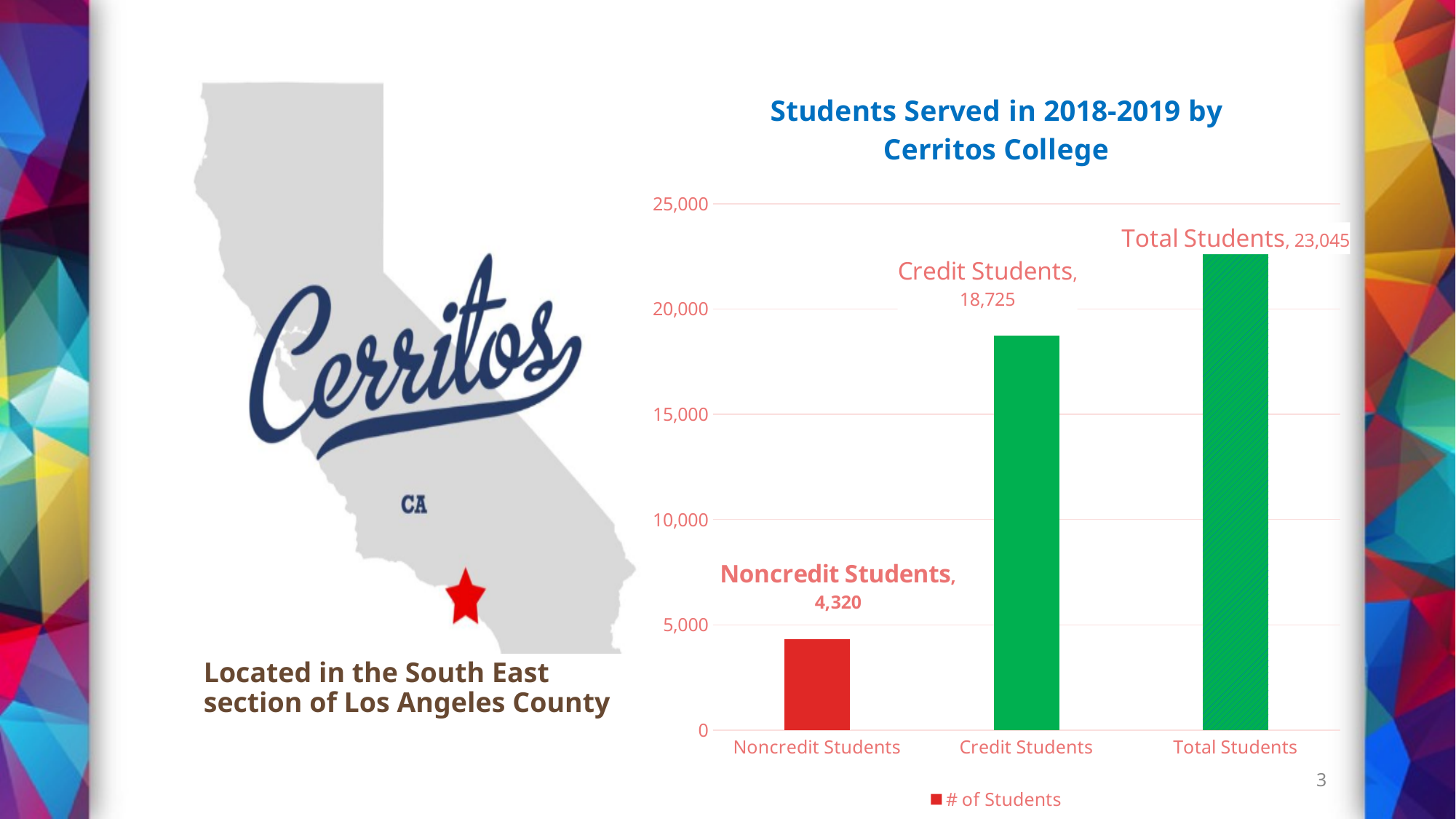
What kind of chart is shown? bar chart Which category has the lowest value? Noncredit Students Is the value for Noncredit Students greater or less than 5,000? less What is the value for Total Students? 23,045 What is the difference between Credit Students and Noncredit Students? 14,405 What is the value for Credit Students? 18,725 Which category has the highest value? Total Students What is the value for Noncredit Students? 4,320 Which is larger, Credit Students or Noncredit Students? Credit Students What is the title of the chart? Students Served in 2018-2019 by Cerritos College What is the difference between Total Students and Credit Students? 4,320 How many categories are shown on the x axis? 3